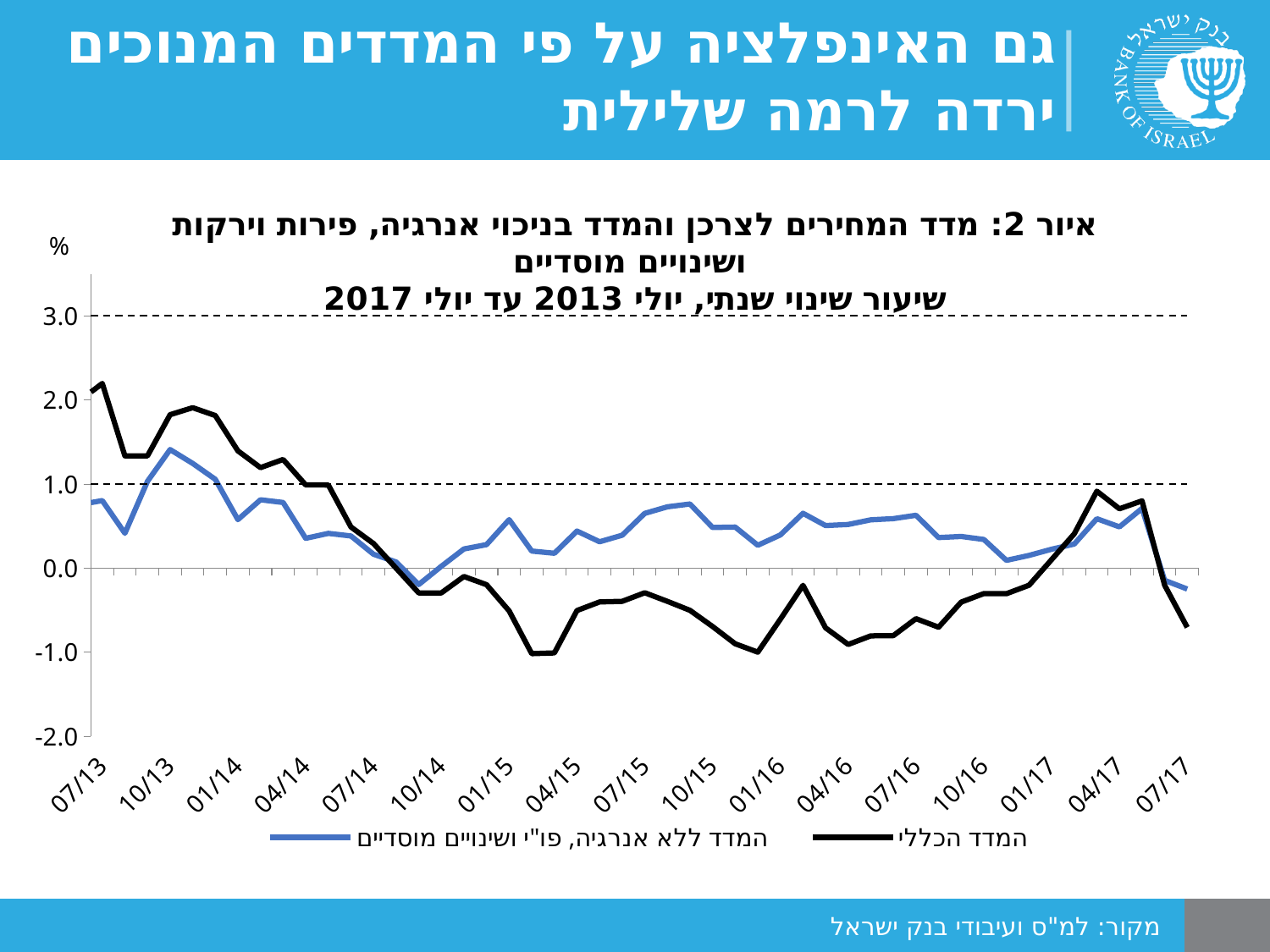
What kind of chart is shown on the slide? line chart How many date labels are shown on the x axis? 17 Is the value of המדד הכללי at 01/14 greater or less than 1.0? greater At 07/13, which series has the higher value, המדד הכללי or המדד ללא אנרגיה, פו"י ושינויים מוסדיים? המדד הכללי What unit is shown at the top of the y axis? % How many series does the legend list? 2 Which series is drawn in black according to the legend? המדד הכללי Does the המדד הכללי line rise or fall between 07/13 and 07/14? fall At 07/17, which series has the higher value, המדד הכללי or המדד ללא אנרגיה, פו"י ושינויים מוסדיים? המדד ללא אנרגיה, פו"י ושינויים מוסדיים Is the value of המדד הכללי at 07/17 greater or less than 0.0? less Is the value of המדד הכללי at 07/13 greater or less than 2.0? greater